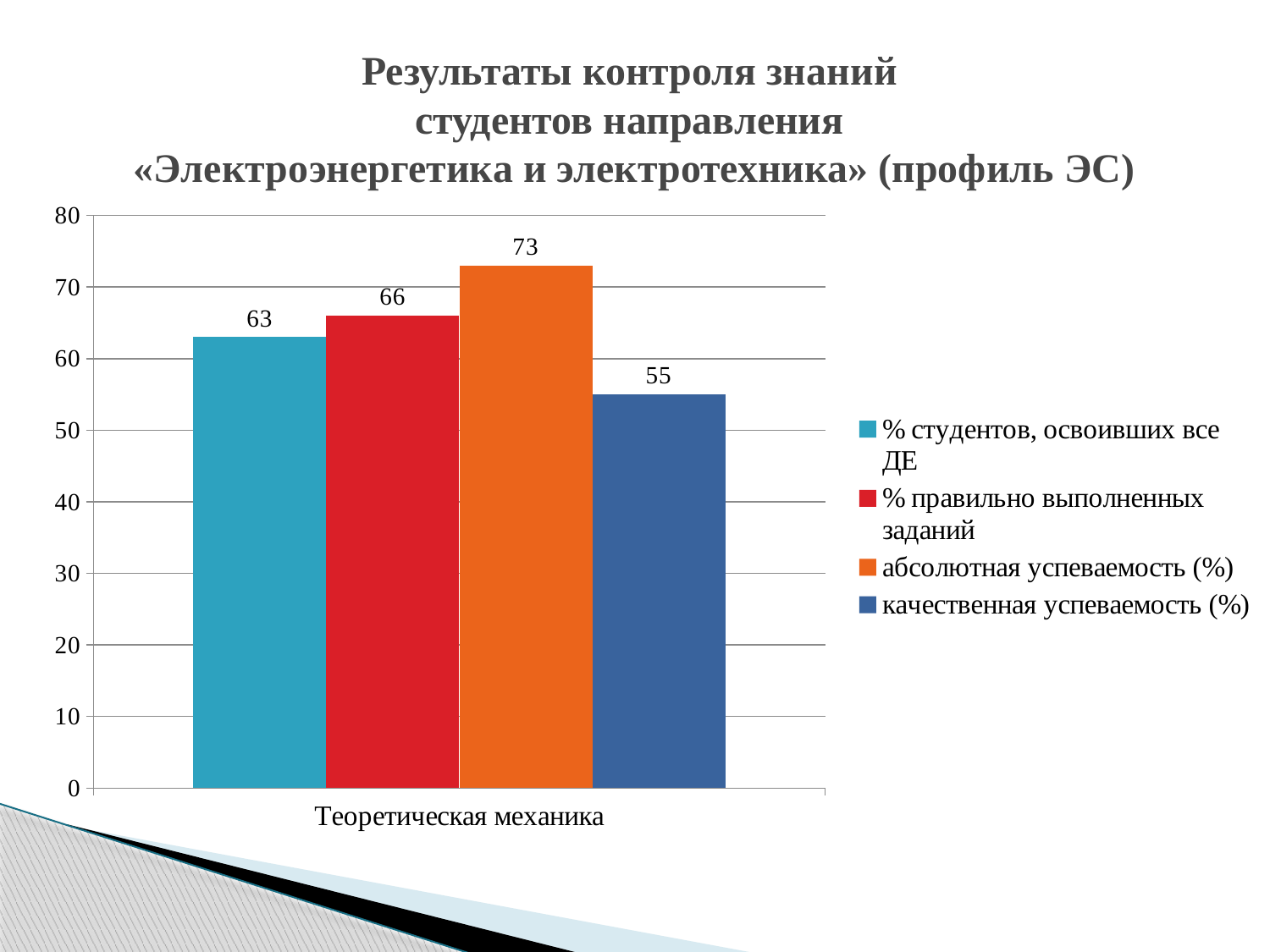
Which is larger for Теоретическая механика: "% правильно выполненных заданий" or "% студентов, освоивших все ДЕ"? % правильно выполненных заданий Which series has the highest value for Теоретическая механика? абсолютная успеваемость (%) How many categories are shown on the x axis? 1 Is the value for "качественная успеваемость (%)" greater or less than 60? less What is the value for "% правильно выполненных заданий" for Теоретическая механика? 66 What is the value for "% студентов, освоивших все ДЕ" for Теоретическая механика? 63 What kind of chart is shown on the slide? bar chart Which series has the lowest value for Теоретическая механика? качественная успеваемость (%) How many series does the legend list? 4 What is the value for "качественная успеваемость (%)" for Теоретическая механика? 55 What is the value for "абсолютная успеваемость (%)" for Теоретическая механика? 73 What is the difference between "абсолютная успеваемость (%)" and "качественная успеваемость (%)" for Теоретическая механика? 18